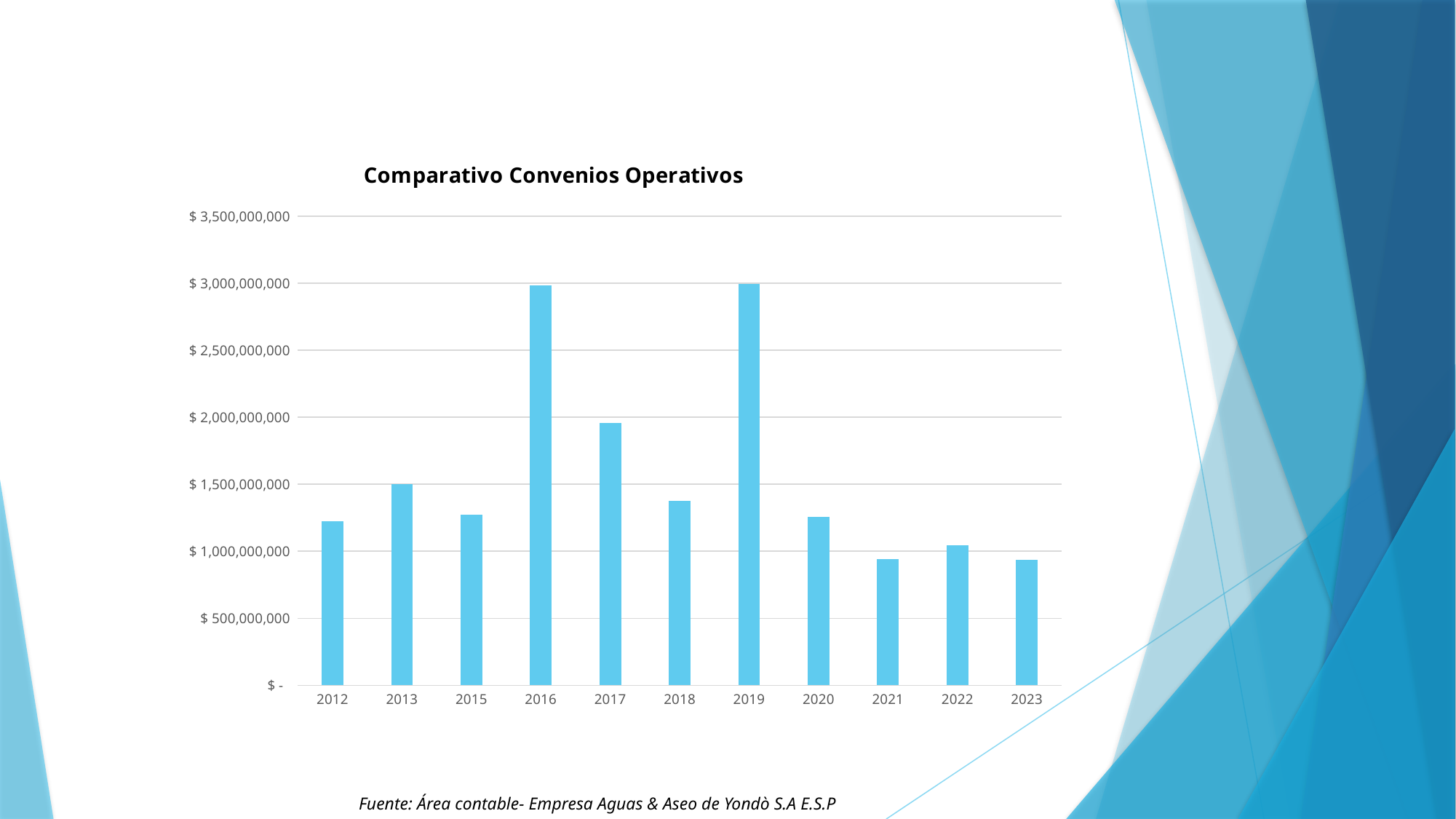
What kind of chart is shown on the slide? Bar chart Is the value for 2021 greater or less than $ 1,000,000,000? less Is the value for 2017 greater or less than $ 1,500,000,000? greater What is the title of the chart? Comparativo Convenios Operativos How many years are shown on the x axis of the chart? 11 Is the value for 2020 greater or less than $ 1,500,000,000? less Which year has the larger value, 2017 or 2018? 2017 Do the values rise or fall from 2019 to 2021? fall What source is cited below the chart? Área contable- Empresa Aguas & Aseo de Yondò S.A E.S.P Which year has the larger value, 2012 or 2013? 2013